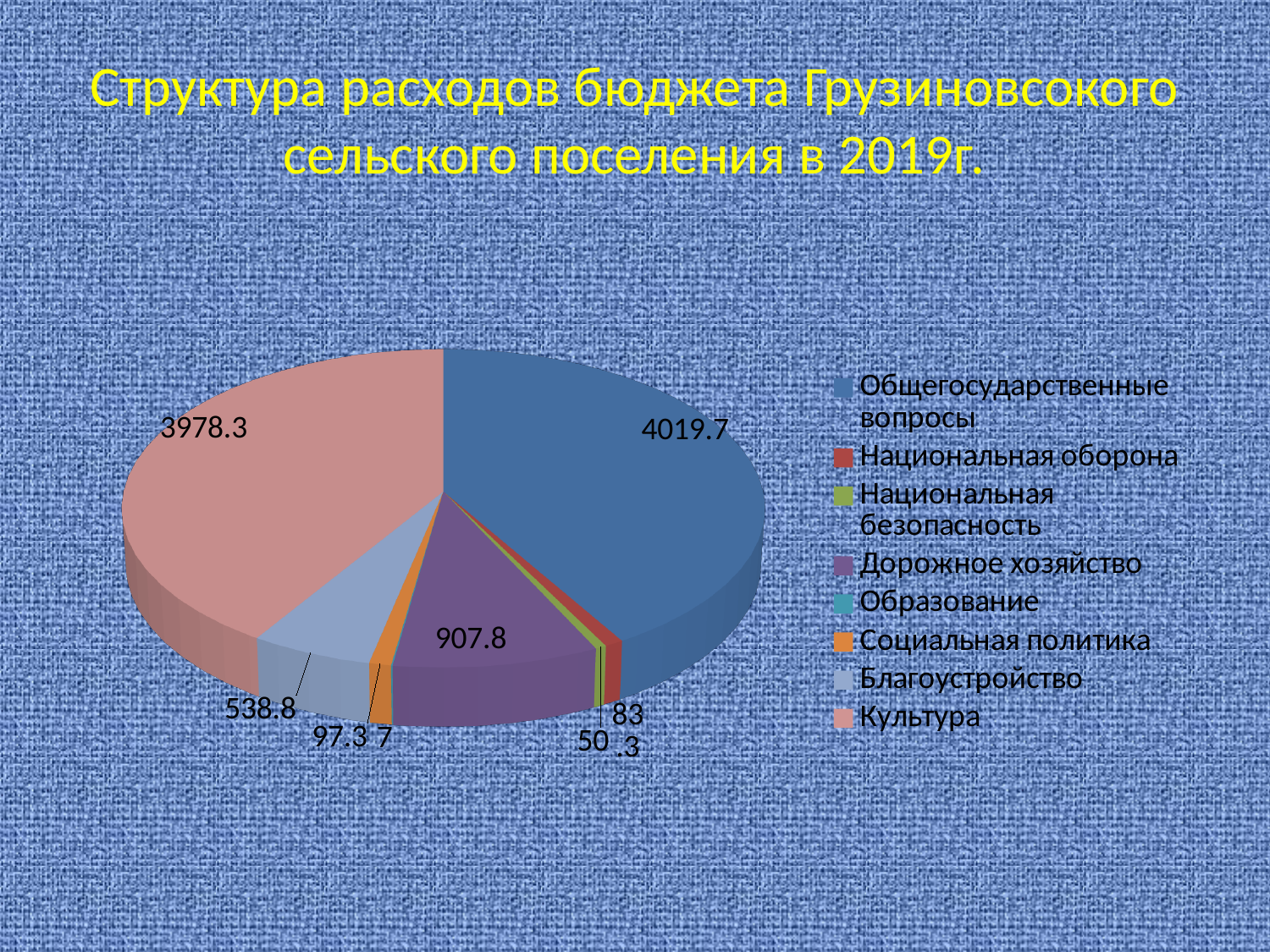
What is the value for Общегосударственные вопросы? 4019.7 What is the value for Дорожное хозяйство? 907.8 What is the value for Социальная политика? 97.3 Which category is shown in pink in the legend? Культура What is the value for Благоустройство? 538.8 What is the difference between the values for Общегосударственные вопросы and Культура? 41.4 What is the value for Культура? 3978.3 Which category has the largest slice of the pie? Общегосударственные вопросы How many categories does the legend list? 8 Which is larger, the value for Дорожное хозяйство or the value for Благоустройство? Дорожное хозяйство What type of chart is shown on the slide? pie chart Which category has the smallest slice of the pie? Образование